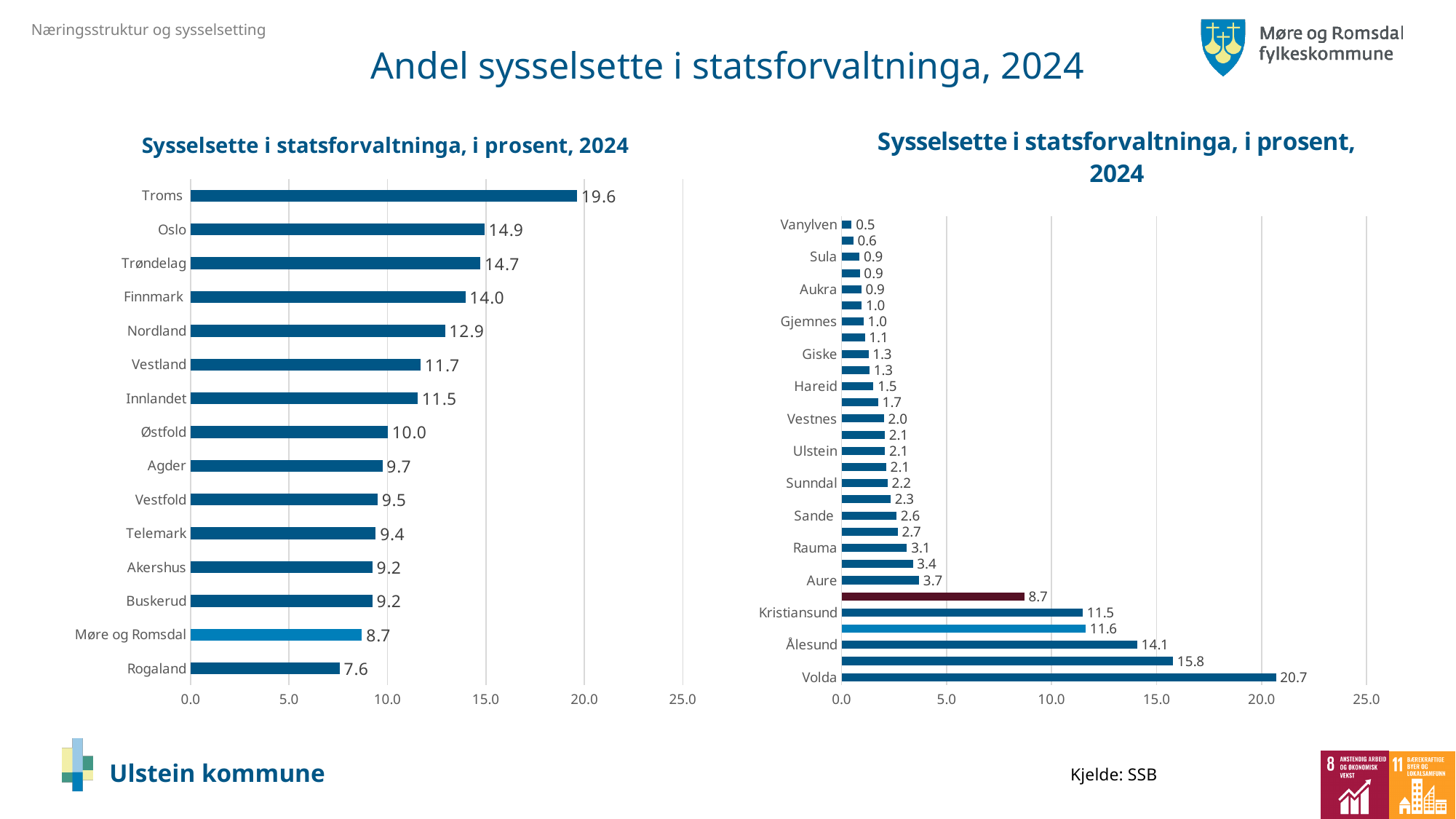
In the left chart, what is the difference between the values for Troms and Oslo? 4.7 In the left chart, what is the value for Møre og Romsdal? 8.7 In the left chart, is the value for Nordland greater or less than 10.0? greater In the right chart, what is the difference between the values for Ålesund and Kristiansund? 2.6 In the right chart, what is the value for Volda? 20.7 In the left chart, which is larger, the value for Vestland or the value for Innlandet? Vestland In the right chart, what is the value for Ulstein? 2.1 In the left chart, what is the value for Troms? 19.6 What kind of chart is the right chart? Bar chart In the left chart, how many categories are shown? 15 In the right chart, which category has the highest value? Volda In the left chart, which category has the lowest value? Rogaland